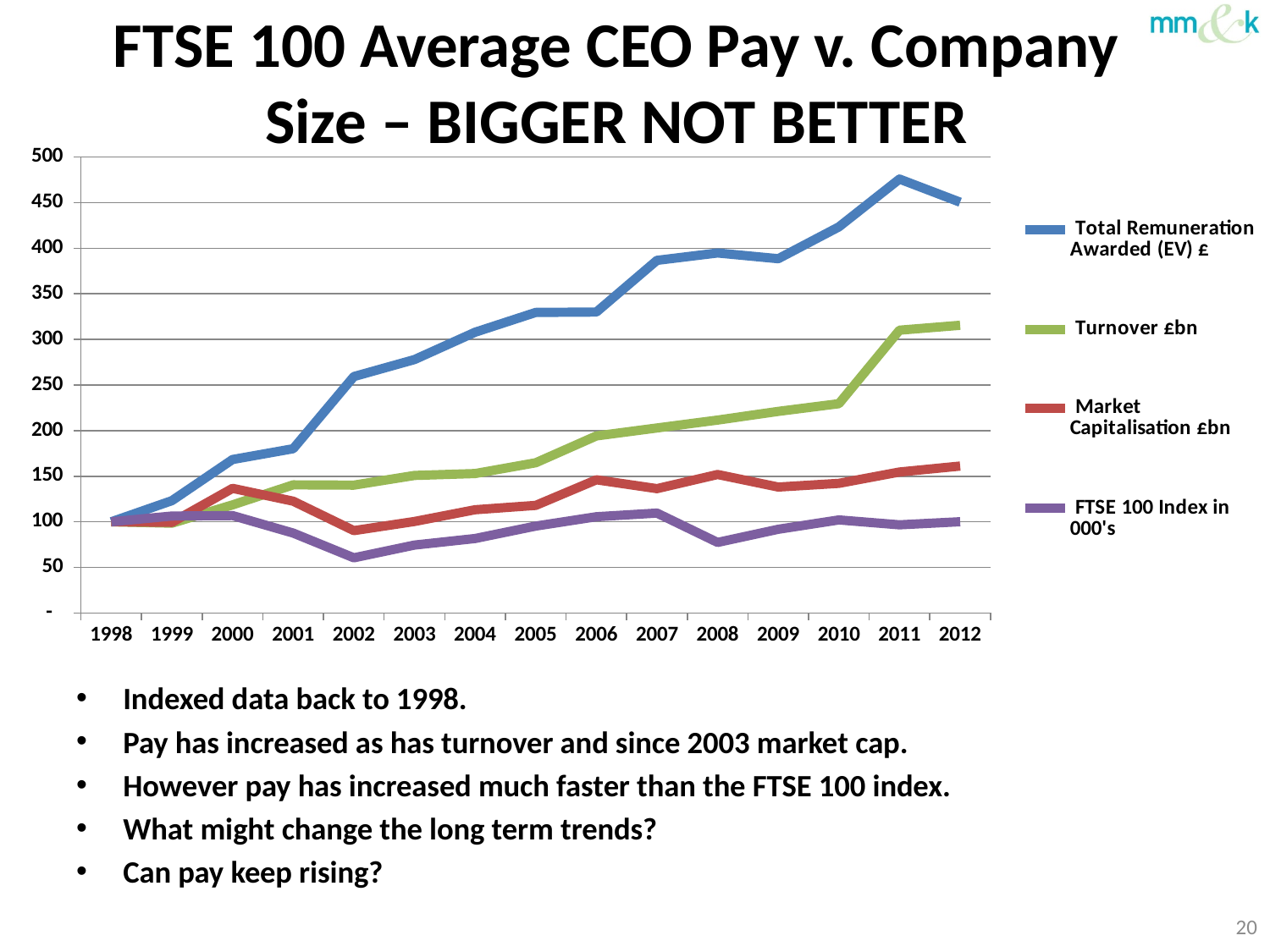
How many series does the chart legend list? 4 Is the value for Turnover £bn in 2011 greater or less than 250? greater In 2008, which is larger: Market Capitalisation £bn or FTSE 100 Index in 000's? Market Capitalisation £bn Which series has the lowest value in 2012? FTSE 100 Index in 000's What kind of chart is shown on the slide? line chart Is the value for Total Remuneration Awarded (EV) £ in 2011 greater or less than 450? greater Which series has the highest value in 2012? Total Remuneration Awarded (EV) £ How many years are plotted along the x axis of the chart? 15 Is the value for Turnover £bn in 2006 greater or less than 150? greater In which year does the Total Remuneration Awarded (EV) £ line reach its highest point? 2011 Does the Total Remuneration Awarded (EV) £ line generally rise or fall from 1998 to 2011? rise